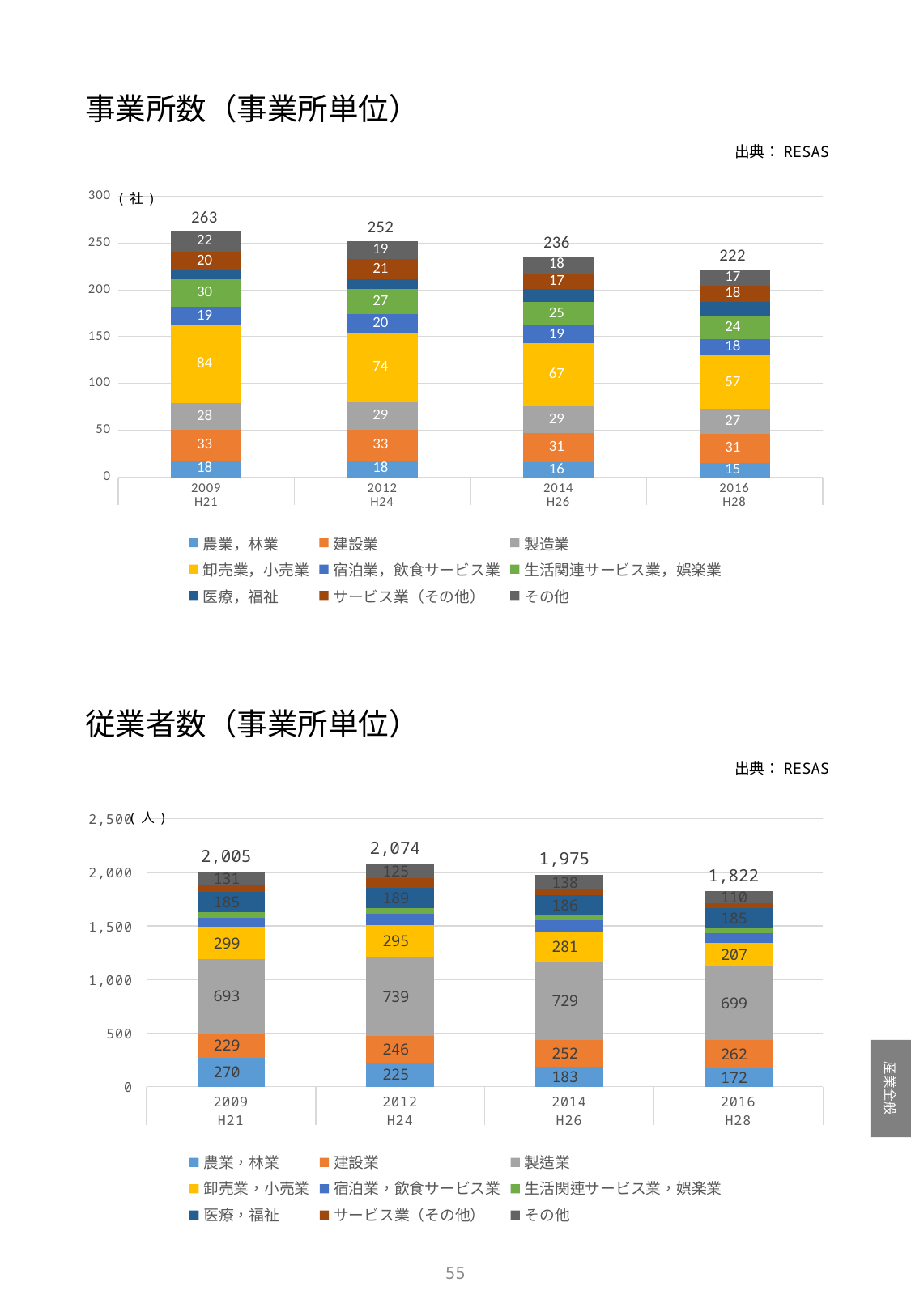
In the 事業所数（事業所単位） chart, how many series does the legend list? 9 In the 事業所数（事業所単位） chart, what is the difference between the 2009 (H21) total and the 2016 (H28) total? 41 In the 事業所数（事業所単位） chart, what is the value for 卸売業，小売業 in 2009 (H21)? 84 In the 従業者数（事業所単位） chart, what is the total number of employees in 2012 (H24)? 2,074 What kind of chart is the 従業者数（事業所単位） chart? stacked bar chart In the 事業所数（事業所単位） chart, which year has the highest total? 2009 (H21) In the 従業者数（事業所単位） chart, how many years are shown on the x axis? 4 In the 従業者数（事業所単位） chart, which is larger, 建設業 in 2009 (H21) or 建設業 in 2016 (H28)? 2016 (H28) In the 事業所数（事業所単位） chart, what is the total number of establishments in 2016 (H28)? 222 In the 従業者数（事業所単位） chart, which year has the lowest total? 2016 (H28) In the 従業者数（事業所単位） chart, what is the value for 製造業 in 2014 (H26)? 729 In the 事業所数（事業所単位） chart, do the totals rise or fall from 2009 to 2016? fall